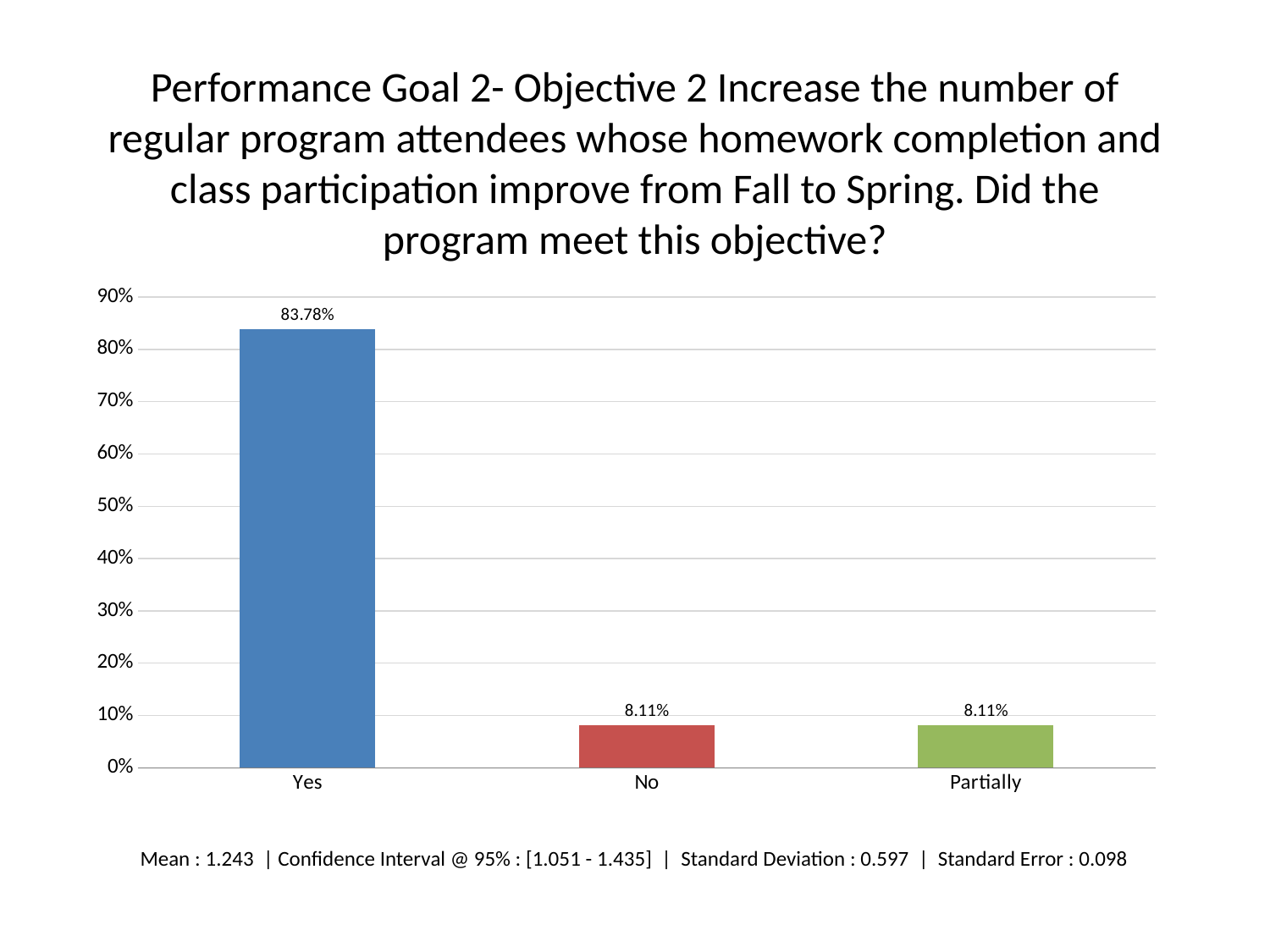
What is the value for Partially? 8.11% Which category has the highest value? Yes What is the value for Yes? 83.78% What is the difference between the values for Yes and No? 75.67% Which is larger, the value for Yes or the value for Partially? Yes What kind of chart is shown on the slide? bar chart Is the value for Yes greater or less than 80%? greater How many categories are shown on the x axis? 3 What is the value for No? 8.11% What is the mean reported below the chart? 1.243 Is the value for No greater or less than 10%? less What colour is the bar for No? red